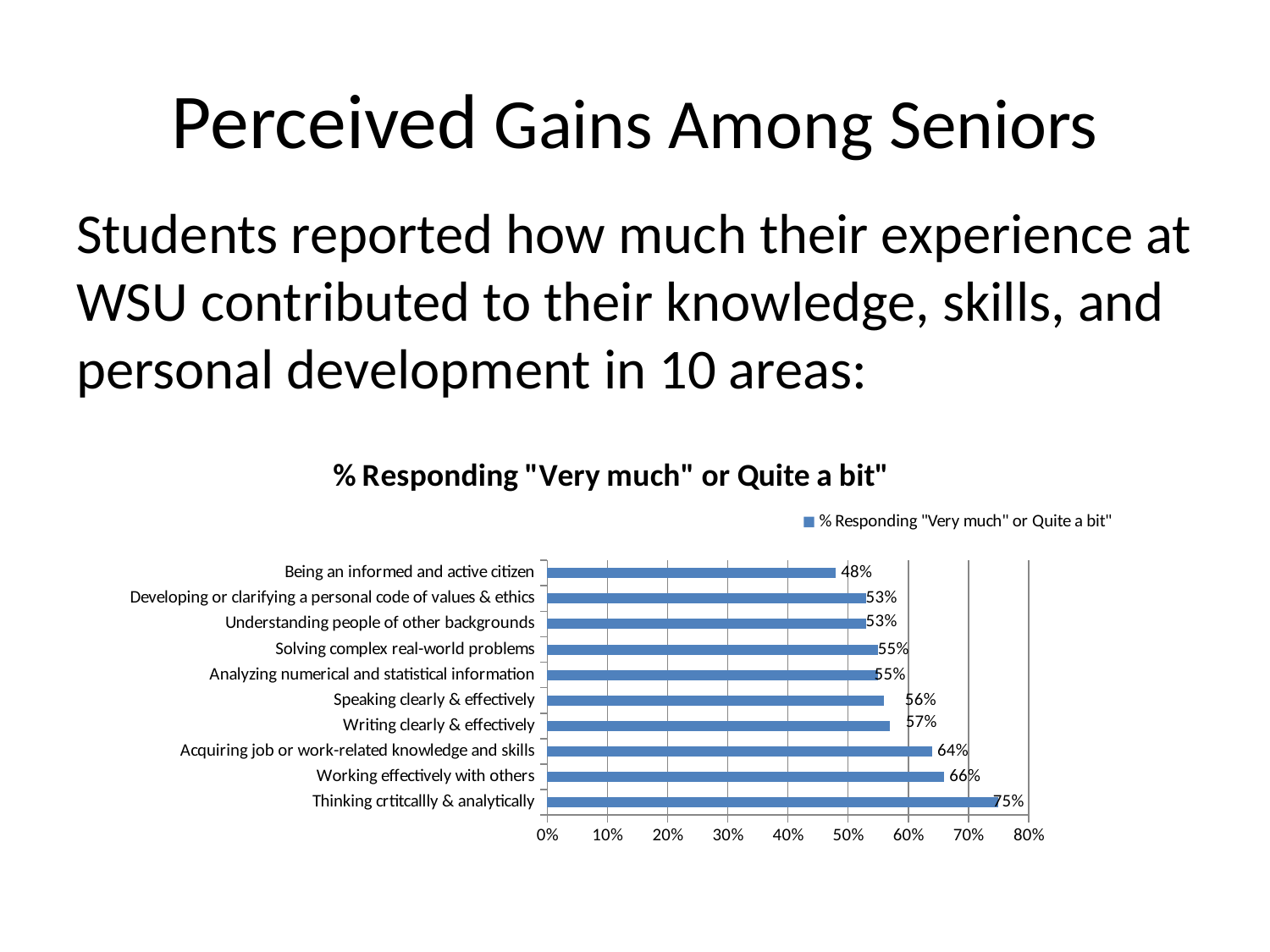
Is the value for Acquiring job or work-related knowledge and skills greater or less than 60%? greater Which area has the highest percentage responding "Very much" or "Quite a bit"? Thinking critically & analytically What is the difference between the values for Thinking critically & analytically and Being an informed and active citizen? 27% What is the value for Acquiring job or work-related knowledge and skills? 64% Which area has the lowest percentage responding "Very much" or "Quite a bit"? Being an informed and active citizen What is the difference between the values for Working effectively with others and Writing clearly & effectively? 9% Which is larger, the value for Working effectively with others or the value for Speaking clearly & effectively? Working effectively with others What is the title of the chart? % Responding "Very much" or Quite a bit" What is the value for Being an informed and active citizen? 48% How many areas are shown in the chart? 10 What kind of chart is shown on the slide? Bar chart What percentage of seniors responded "Very much" or "Quite a bit" for Thinking critically & analytically? 75%